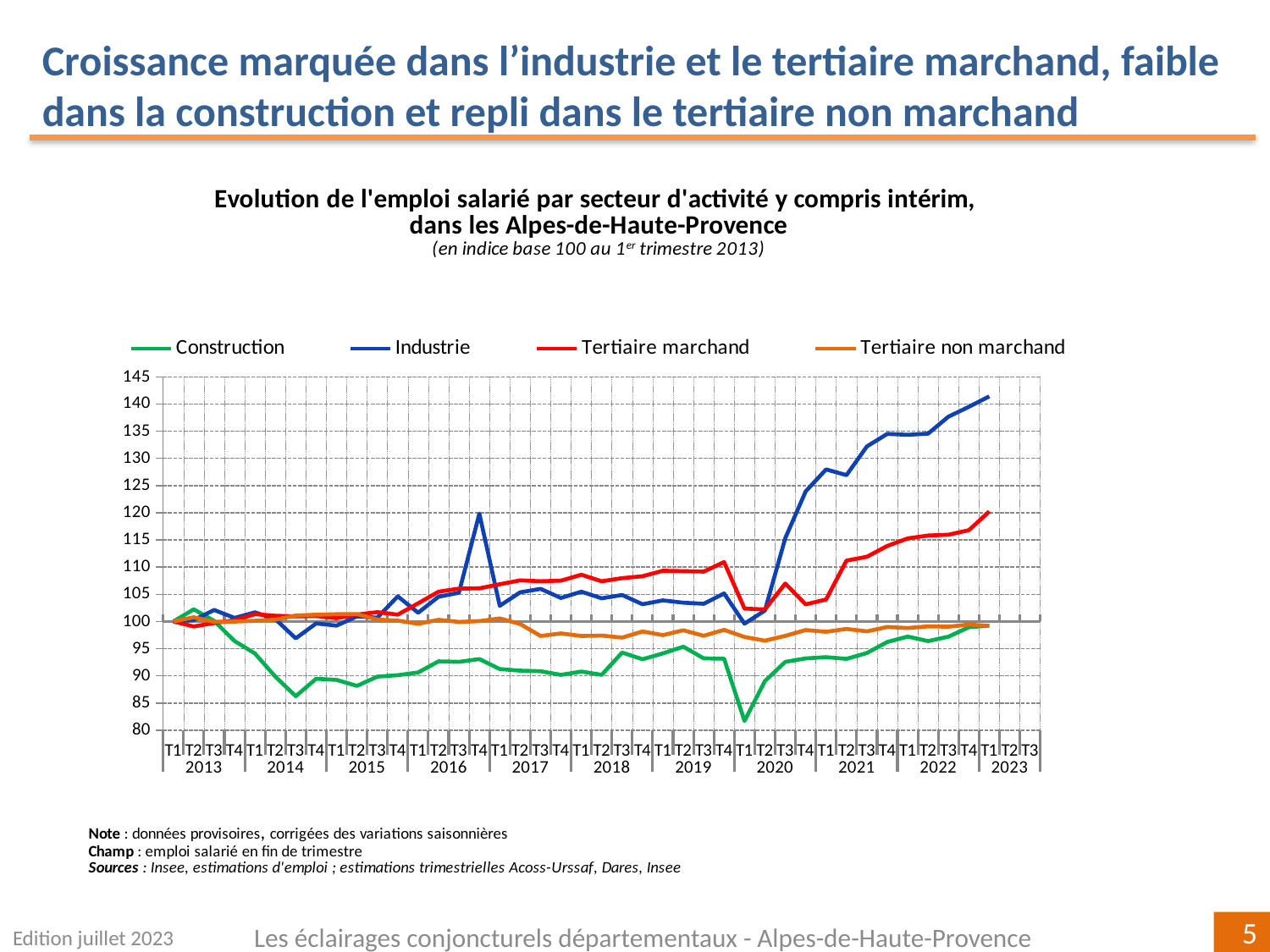
Does the Industrie line rise or fall between T1 2020 and T1 2023? rise How many series does the legend list? 4 Is the value for Construction at T1 2020 greater or less than 85? less Which series has the highest value at T1 2023? Industrie Is the value for Industrie at T1 2023 greater or less than 135? greater Which series are listed in the legend? Construction, Industrie, Tertiaire marchand, Tertiaire non marchand Is the value for Tertiaire marchand at T1 2023 greater or less than 115? greater What kind of chart is shown on the slide? line chart What is the index value of every series at T1 2013? 100 What colour is the Industrie line? blue Which series has the lowest value at T1 2020? Construction At T3 2014, which is larger: Construction or Tertiaire non marchand? Tertiaire non marchand